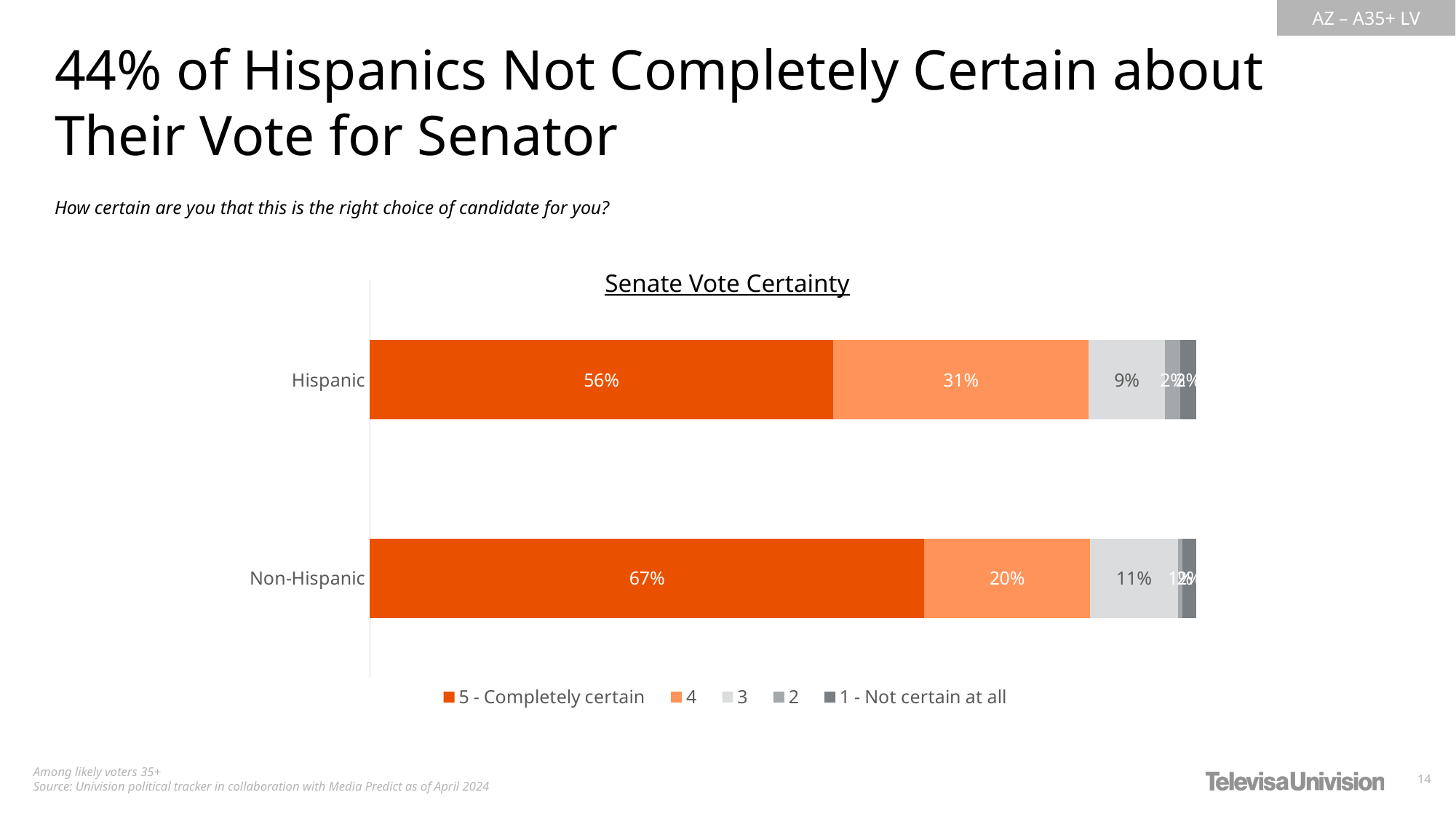
How many series does the legend list? 5 What type of chart is shown on the slide? Stacked bar chart What is the value of the "4" segment for Non-Hispanic respondents? 20% How many groups (bars) are shown in the chart? 2 What is the value of the "3" segment for Non-Hispanic respondents? 11% What is the value of the "4" segment for Hispanic respondents? 31% What is the value of the "3" segment for Hispanic respondents? 9% Which group has a larger share answering "4": Hispanic or Non-Hispanic? Hispanic What percentage of Hispanic respondents answered "5 - Completely certain"? 56% Which group has the highest share of "5 - Completely certain" responses? Non-Hispanic What percentage of Non-Hispanic respondents answered "5 - Completely certain"? 67% What is the difference in percentage points between Non-Hispanic and Hispanic respondents who are "5 - Completely certain"? 11 percentage points